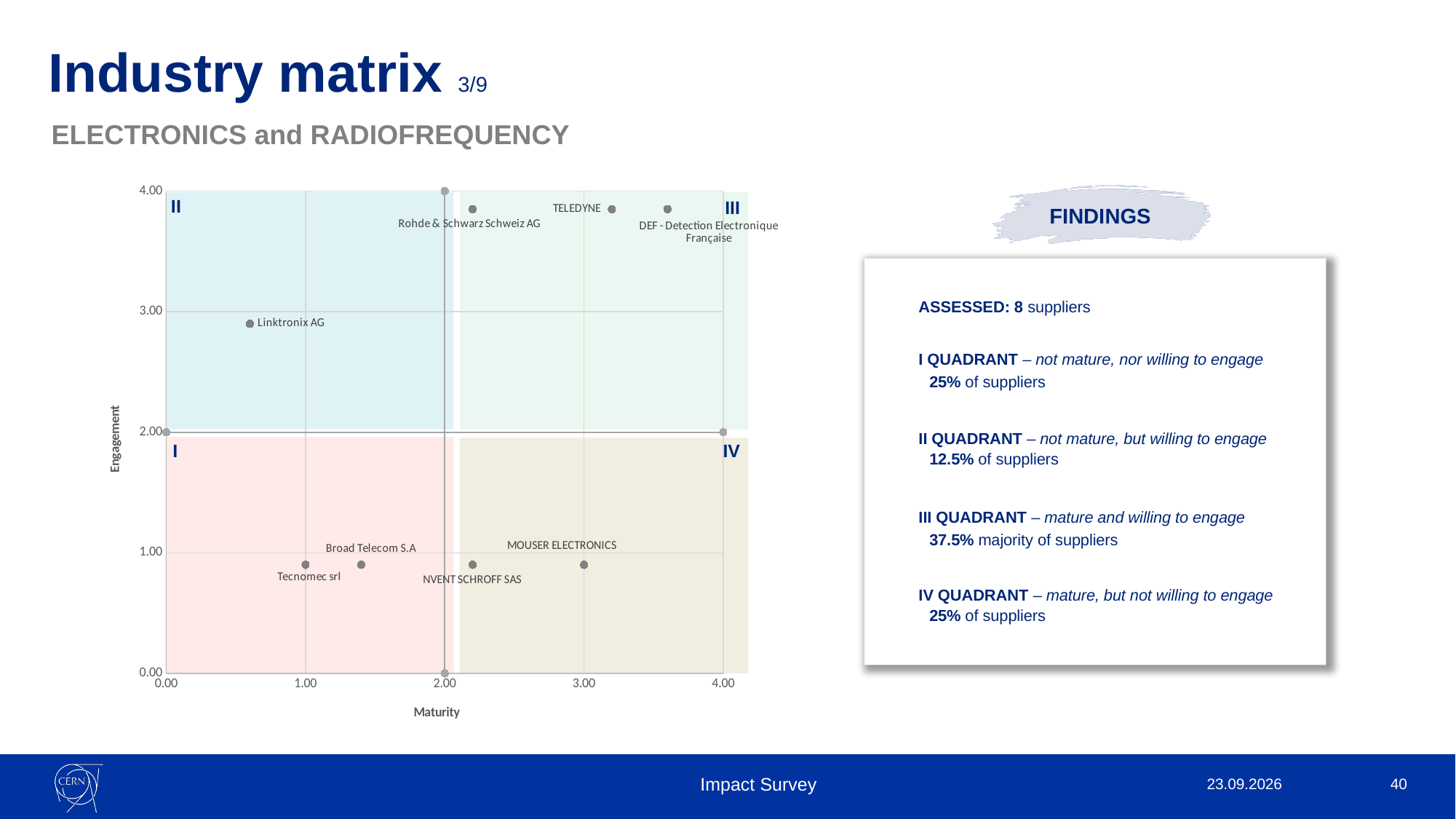
Which supplier has a higher Engagement value, Linktronix AG or Tecnomec srl? Linktronix AG How many supplier points are plotted on the chart? 8 Which supplier has a higher Maturity value, MOUSER ELECTRONICS or NVENT SCHROFF SAS? MOUSER ELECTRONICS What kind of chart is shown on the slide? scatter chart Is the Maturity value for Linktronix AG greater or less than 1.00? less Which supplier has the highest Maturity value on the chart? DEF - Detection Electronique Française Is the Maturity value for TELEDYNE greater or less than 3.00? greater Is the Engagement value for Linktronix AG greater or less than 2.00? greater Which supplier has the lowest Maturity value on the chart? Linktronix AG What is the label of the horizontal axis of the chart? Maturity What is the label of the vertical axis of the chart? Engagement